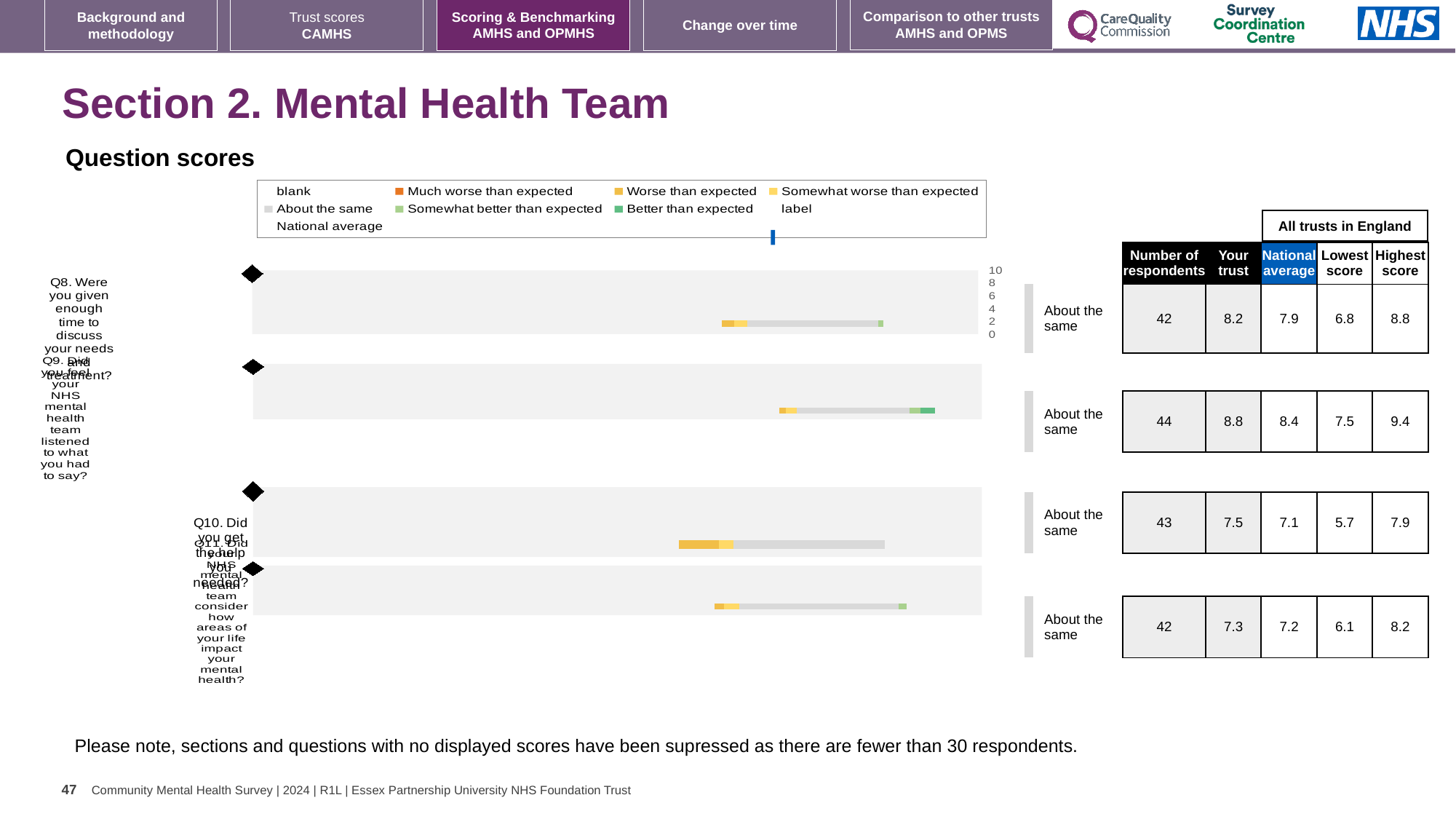
In the table next to the chart, what is the National average for Q9 (Did you feel your NHS mental health team listened to what you had to say)? 8.4 How many questions (bars) are plotted in the Question scores chart? 4 Which question has the lowest 'Your trust' score in the table next to the chart? Q11 In the table next to the chart, what is the Highest score across all trusts in England for Q11? 8.2 What is the difference between the 'Your trust' score and the National average for Q9 in the table? 0.4 What kind of chart is used to show the question scores on this slide? bar chart In the table next to the chart, what is the 'Your trust' score for Q8 (Were you given enough time to discuss your needs and treatment)? 8.2 Which question has the highest 'Your trust' score in the table next to the chart? Q9 What is the maximum value shown on the chart's score axis? 10 In the table next to the chart, how many respondents answered Q10 (Did you get the help you needed)? 43 What benchmark label is shown to the right of the chart for Q10? About the same For Q8, which is larger in the table: the 'Your trust' score or the National average? Your trust